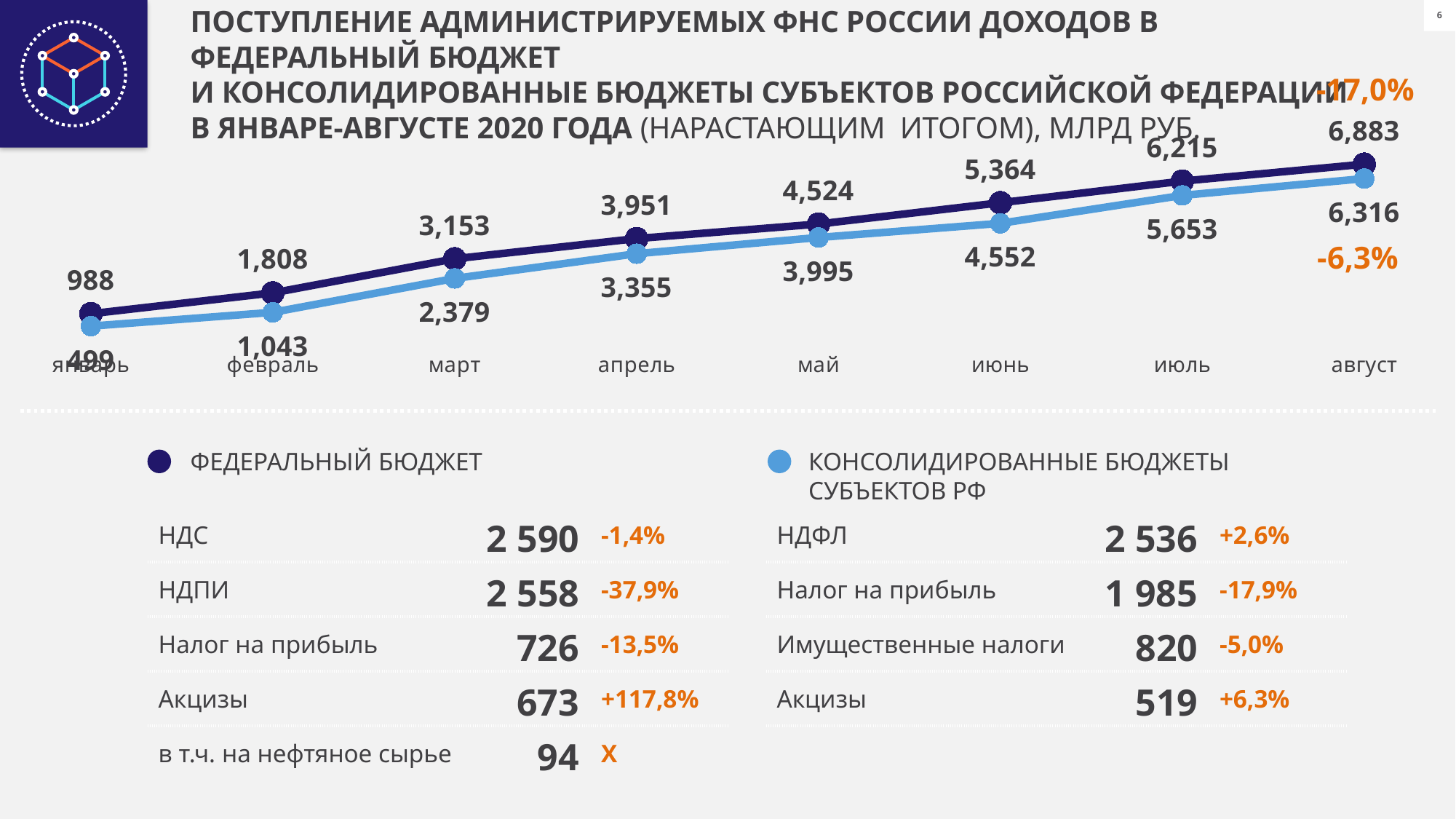
What is the value for КОНСОЛИДИРОВАННЫЕ БЮДЖЕТЫ СУБЪЕКТОВ РФ in май? 3,995 What is the value for ФЕДЕРАЛЬНЫЙ БЮДЖЕТ in август? 6,883 What is the value for ФЕДЕРАЛЬНЫЙ БЮДЖЕТ in март? 3,153 Do the ФЕДЕРАЛЬНЫЙ БЮДЖЕТ values rise or fall from январь to август? rise How many series does the chart legend list? 2 In which month is the КОНСОЛИДИРОВАННЫЕ БЮДЖЕТЫ СУБЪЕКТОВ РФ value highest? август How many months are plotted along the x axis of the chart? 8 Which series has the larger value in июль, ФЕДЕРАЛЬНЫЙ БЮДЖЕТ or КОНСОЛИДИРОВАННЫЕ БЮДЖЕТЫ СУБЪЕКТОВ РФ? ФЕДЕРАЛЬНЫЙ БЮДЖЕТ What is the value for КОНСОЛИДИРОВАННЫЕ БЮДЖЕТЫ СУБЪЕКТОВ РФ in январь? 499 What kind of chart is shown on the slide? line chart In which month is the ФЕДЕРАЛЬНЫЙ БЮДЖЕТ value lowest? январь What is the difference between the ФЕДЕРАЛЬНЫЙ БЮДЖЕТ and КОНСОЛИДИРОВАННЫЕ БЮДЖЕТЫ СУБЪЕКТОВ РФ values in август? 567